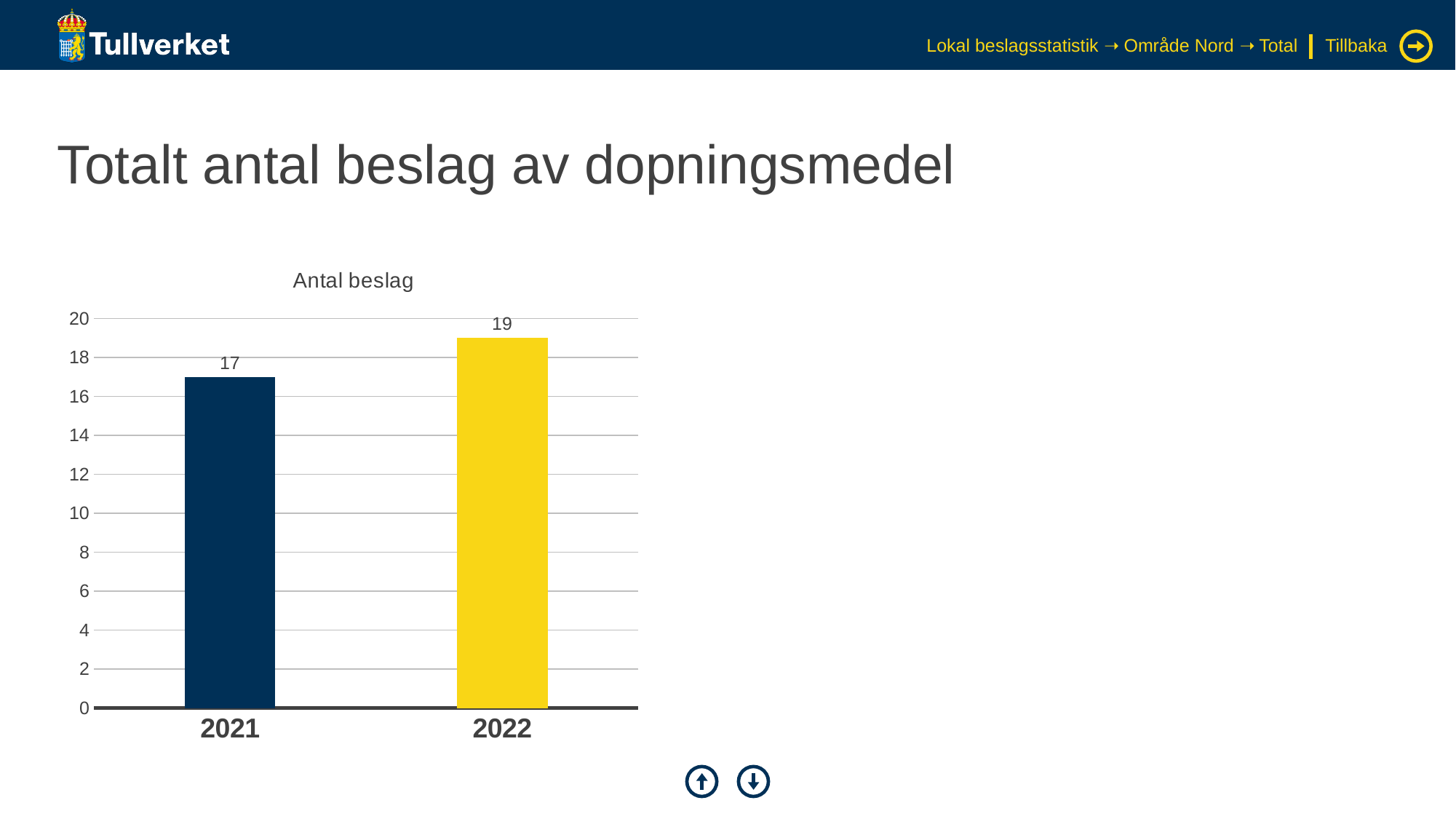
What is the title of the chart? Antal beslag What is the value for 2021? 17 Is the value for 2021 greater or less than 18? less What is the difference between the values for 2022 and 2021? 2 Do the values rise or fall from 2021 to 2022? rise Is the value for 2022 greater or less than 18? greater What kind of chart is shown on the slide? bar chart What is the value for 2022? 19 How many categories are shown on the x axis? 2 Which year has the highest number of seizures? 2022 Which year has the lowest number of seizures? 2021 Which is larger, the value for 2021 or the value for 2022? 2022